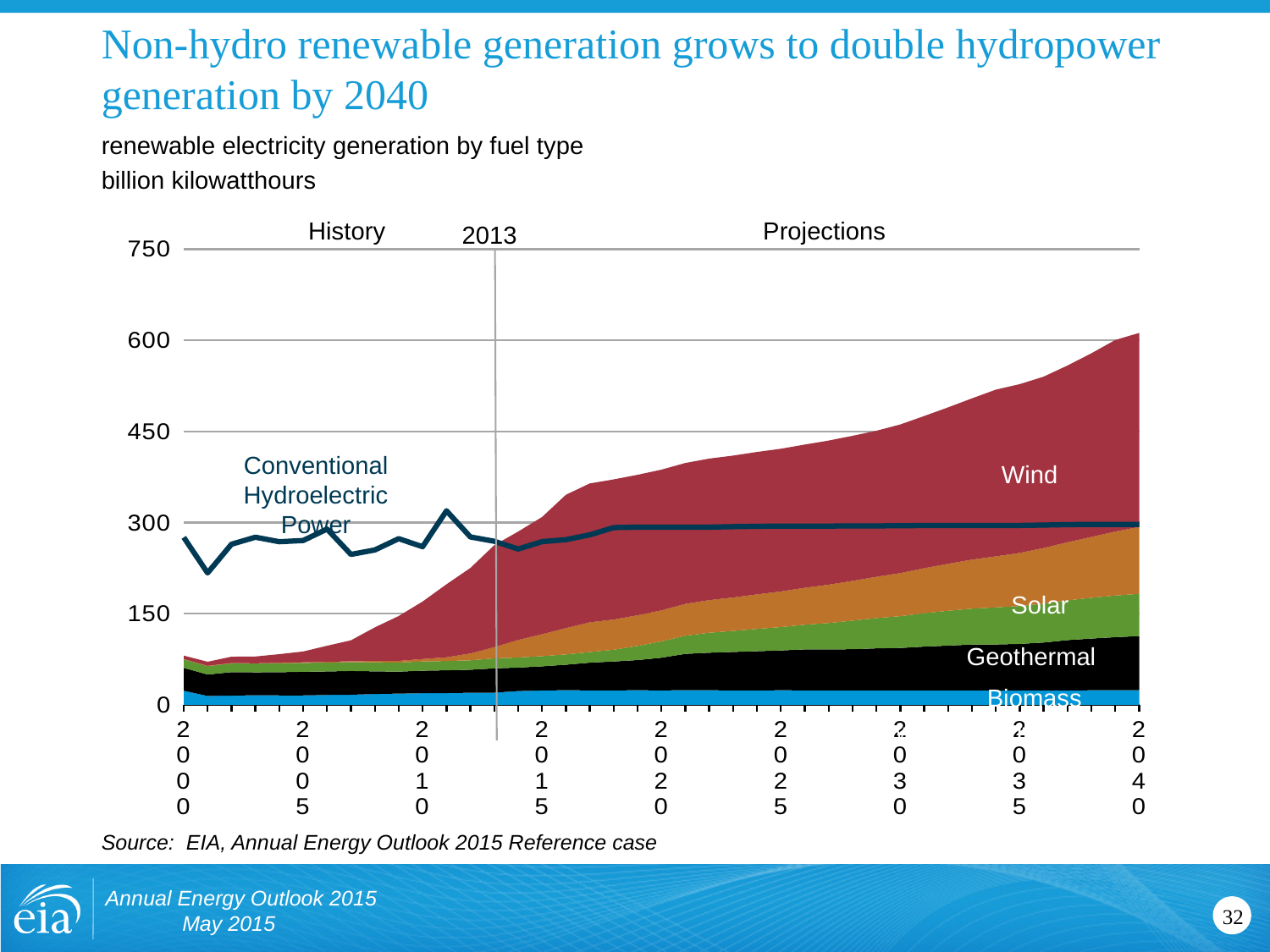
What unit is the y axis of the chart measured in? billion kilowatthours Which fuel type has the largest area in 2040? Wind How many fuel-type series are labeled on the chart? 5 In 2040, which is larger: total non-hydro renewable generation or Conventional Hydroelectric Power generation? total non-hydro renewable generation Does total non-hydro renewable generation rise or fall from 2013 to 2040? rise Is the total non-hydro renewable generation in 2040 greater or less than 450? greater What is the title of the chart on the slide? Non-hydro renewable generation grows to double hydropower generation by 2040 Is Conventional Hydroelectric Power generation in 2040 greater or less than 150? greater How many year labels are shown on the x axis? 9 What kind of chart is shown on the slide? stacked area chart with a line Is the total non-hydro renewable generation in 2000 greater or less than 150? less